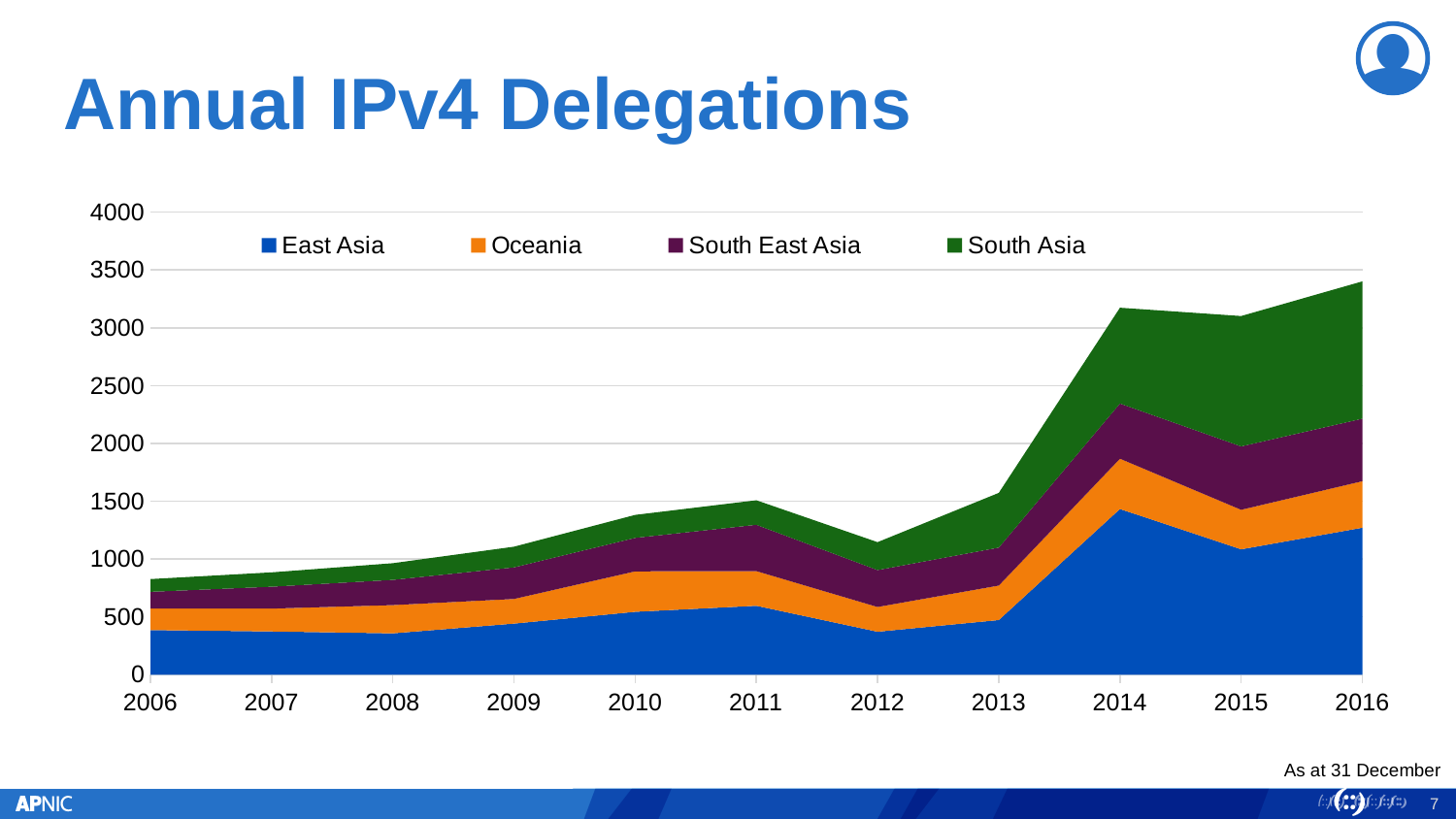
How many series does the legend list? 4 How many years are shown along the x axis? 11 Which series is shown in green in the legend? South Asia Which year has the larger total, 2012 or 2014? 2014 Is the total for 2014 greater or less than 3000? greater In which year is the total of all regions highest? 2016 In which year is the total of all regions lowest? 2006 Is the East Asia value for 2006 greater or less than 500? less What kind of chart is shown on the slide? Stacked area chart What is the title of the chart? Annual IPv4 Delegations Does the total rise or fall from 2011 to 2012? fall Is the total for 2010 greater or less than 1500? less